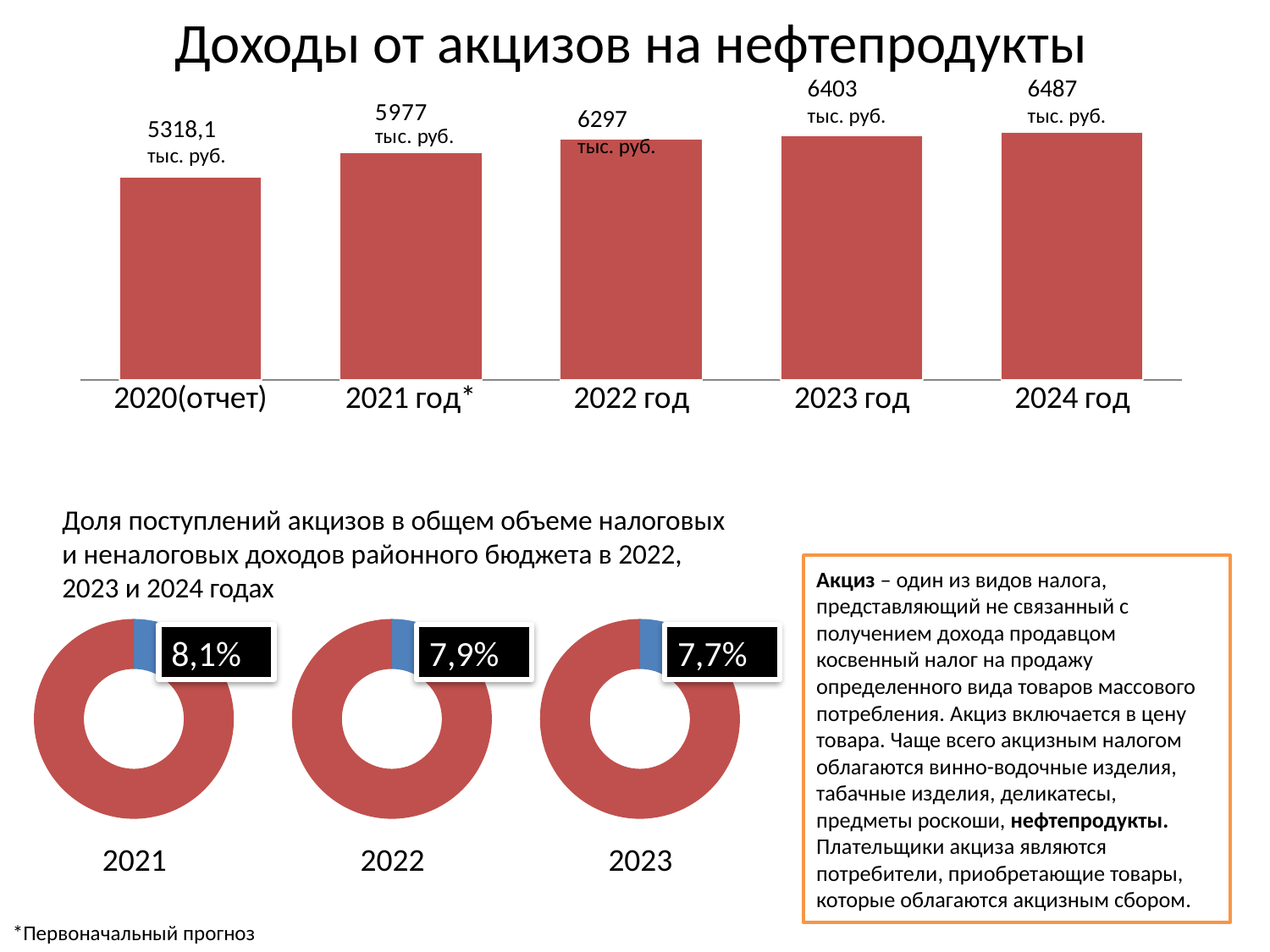
How many bars are in the bar chart 'Доходы от акцизов на нефтепродукты'? 5 In the bar chart 'Доходы от акцизов на нефтепродукты', which year has the highest value? 2024 год In the bar chart 'Доходы от акцизов на нефтепродукты', what is the value for 2020(отчет)? 5318,1 тыс. руб. In the bar chart 'Доходы от акцизов на нефтепродукты', what is the value for 2024 год? 6487 тыс. руб. In the bar chart 'Доходы от акцизов на нефтепродукты', which year has the lowest value? 2020(отчет) In the bar chart 'Доходы от акцизов на нефтепродукты', what is the difference between the values for 2024 год and 2023 год? 84 тыс. руб. In the bar chart 'Доходы от акцизов на нефтепродукты', which is larger: the value for 2021 год* or the value for 2022 год? 2022 год In the donut chart labelled 2022 at the bottom of the slide, what share is shown for the highlighted slice? 7,9% Among the three donut charts at the bottom of the slide, which year shows the lowest share? 2023 In the bar chart 'Доходы от акцизов на нефтепродукты', what is the value for 2022 год? 6297 тыс. руб. In the bar chart 'Доходы от акцизов на нефтепродукты', do the values rise or fall from 2020(отчет) to 2024 год? Rise What kind of chart is the top chart 'Доходы от акцизов на нефтепродукты'? Bar chart